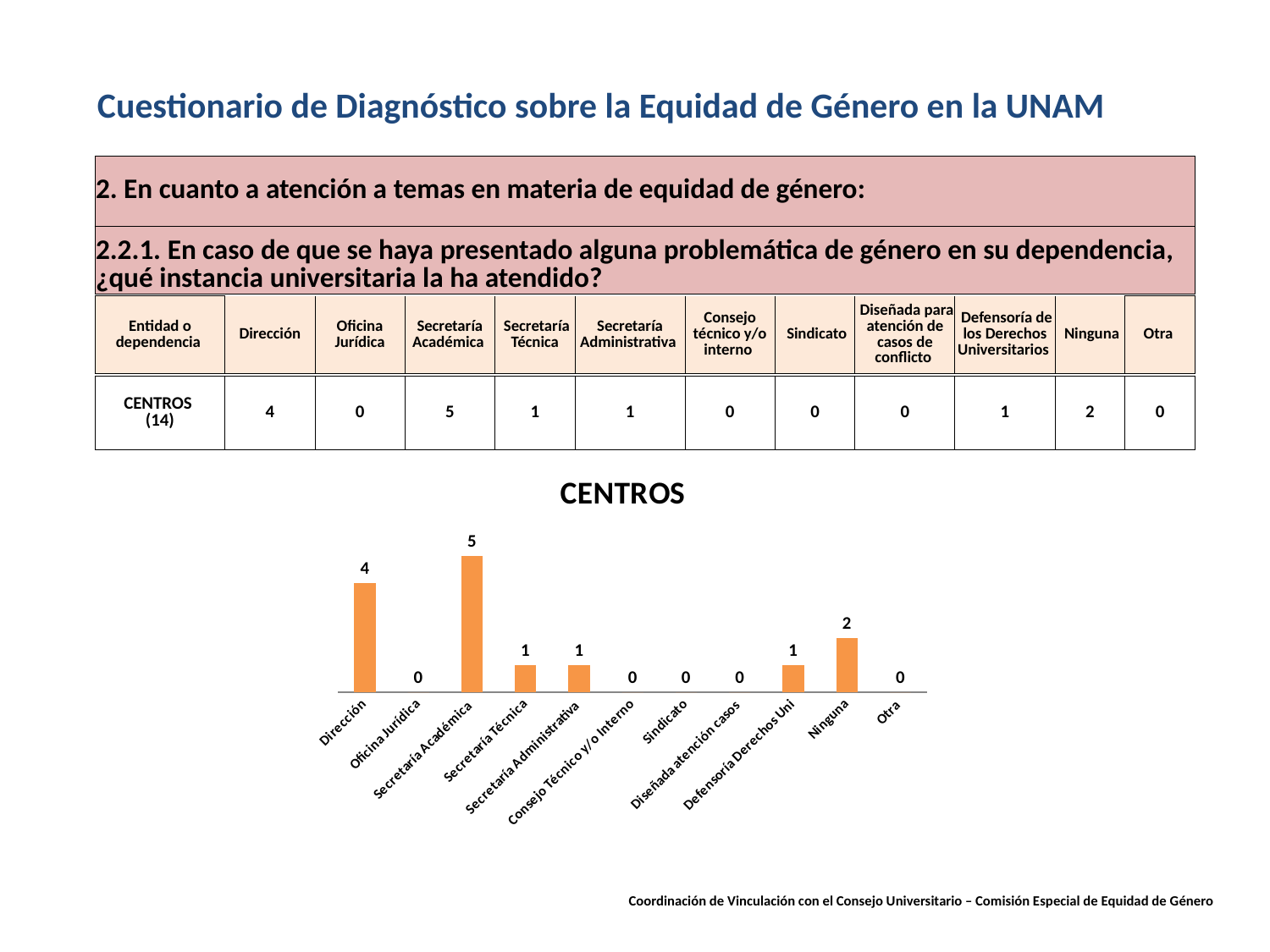
What is the difference between the values for Secretaría Académica and Dirección in the CENTROS chart? 1 What is the value for Secretaría Académica in the CENTROS chart? 5 What is the value for Dirección in the CENTROS chart? 4 What is the value for Defensoría Derechos Uni in the CENTROS chart? 1 How many categories are shown on the x axis of the CENTROS chart? 11 Which is larger in the CENTROS chart, the value for Ninguna or the value for Secretaría Técnica? Ninguna What is the difference between the values for Dirección and Ninguna in the CENTROS chart? 2 What is the title of the chart on the slide? CENTROS Which category has the highest value in the CENTROS chart? Secretaría Académica How many categories in the CENTROS chart have a value of 0? 5 What is the value for Ninguna in the CENTROS chart? 2 What kind of chart is the CENTROS chart? Bar chart